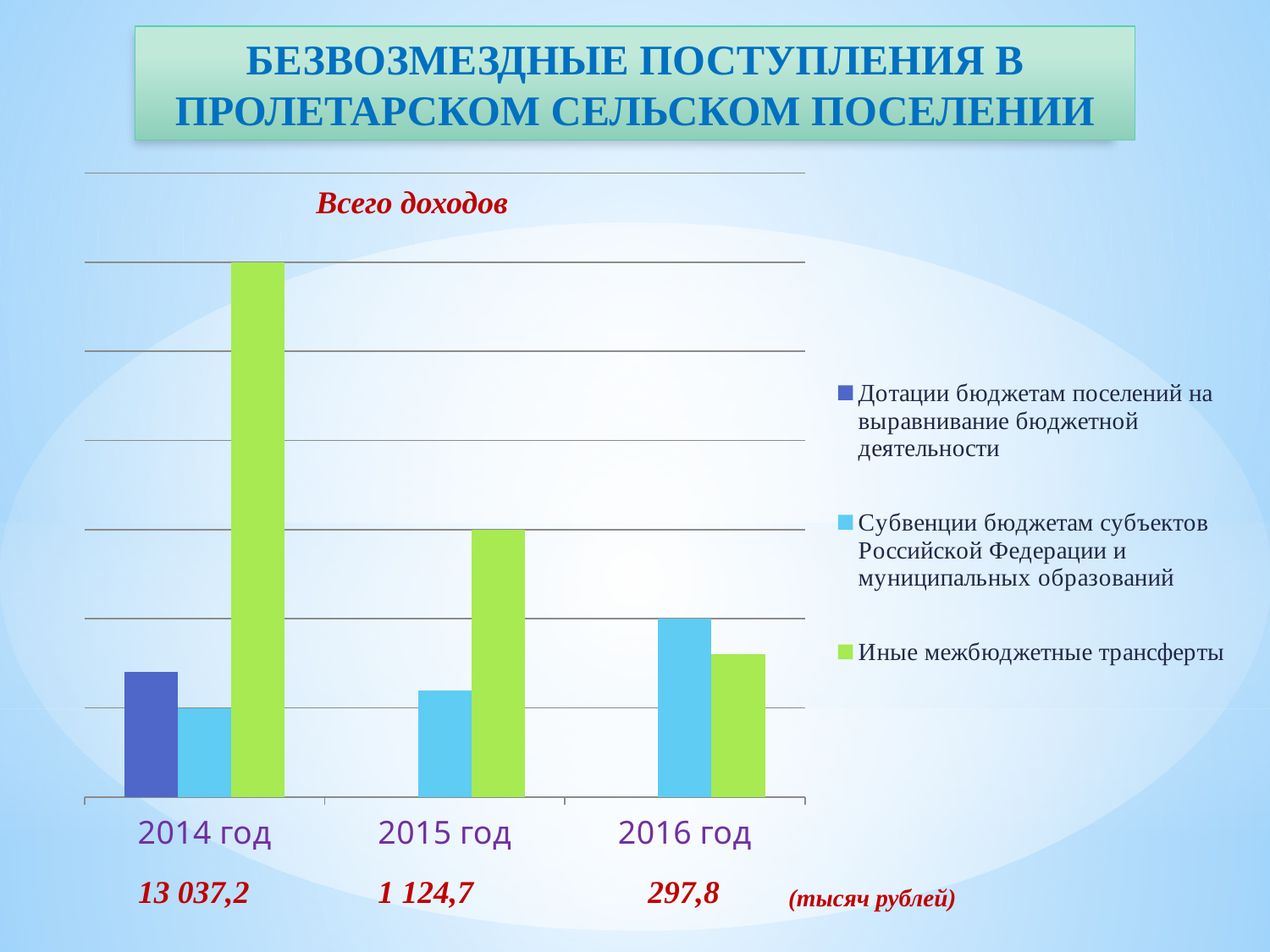
Which year has the lowest total income printed below the chart? 2016 год What is the total income (Всего доходов) printed for 2014 год? 13 037,2 Which year has the highest total income printed below the chart? 2014 год Do the total income values printed below the chart rise or fall from 2014 to 2016? fall How many series does the chart legend list? 3 How many years (categories) are shown on the x axis of the chart? 3 In 2014 год, which series has the tallest bar: Дотации, Субвенции or Иные межбюджетные трансферты? Иные межбюджетные трансферты What kind of chart is shown on the slide? bar chart What is the total income (Всего доходов) printed for 2015 год? 1 124,7 In 2016 год, which bar is taller: Субвенции бюджетам субъектов Российской Федерации и муниципальных образований or Иные межбюджетные трансферты? Субвенции бюджетам субъектов Российской Федерации и муниципальных образований What is the total income (Всего доходов) printed for 2016 год? 297,8 In what units are the values on the slide given, according to the note next to the totals? тысяч рублей